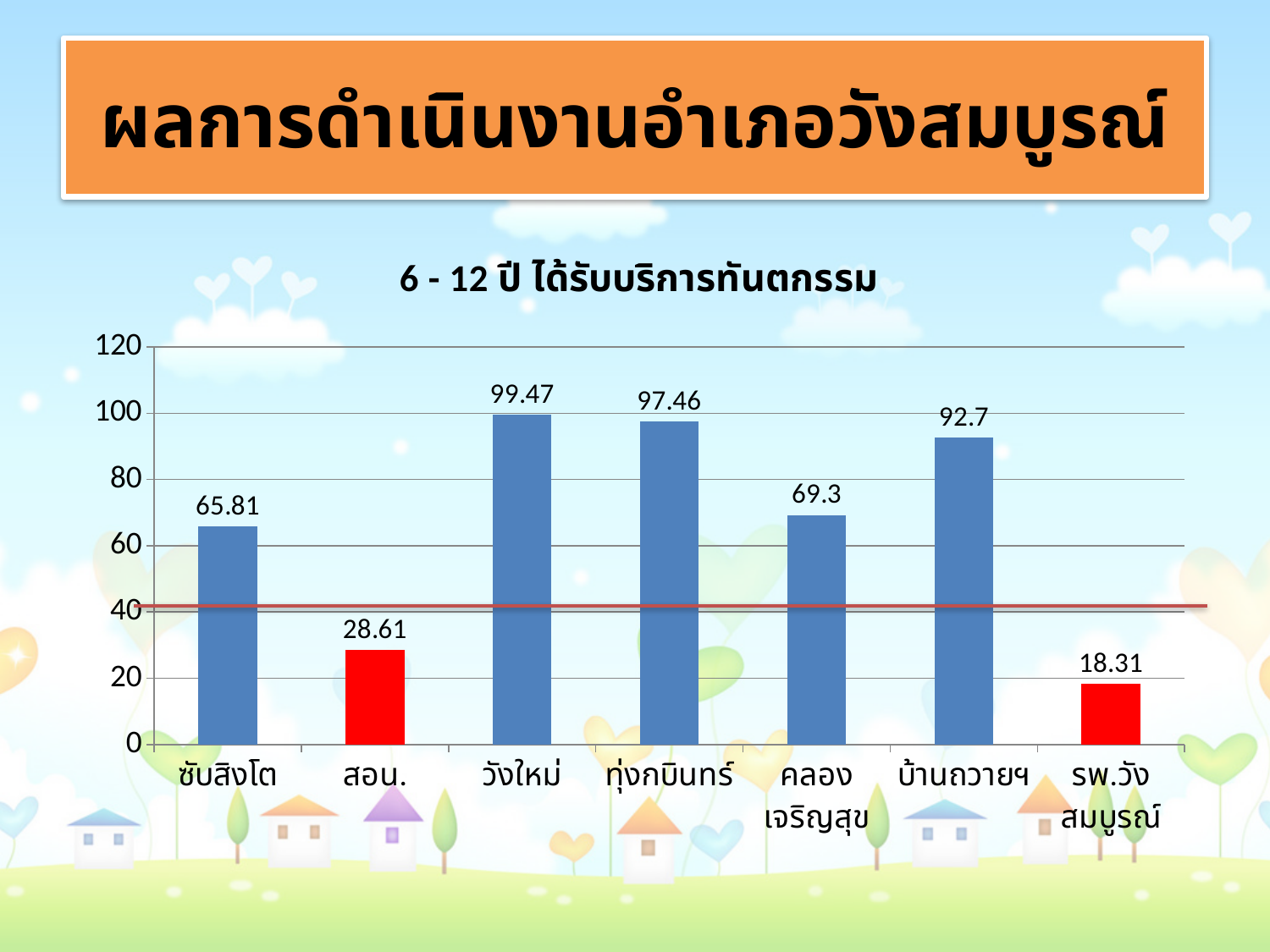
Which category has the lowest value? รพ.วังสมบูรณ์ Which category has the highest value? วังใหม่ What is the value for บ้านถวายฯ? 92.7 What is the difference between the values for ซับสิงโต and คลองเจริญสุข? 3.49 What is the value for สอน.? 28.61 Is the value for รพ.วังสมบูรณ์ greater or less than 20? less What kind of chart is this? bar chart How many bars are coloured red? 2 What is the title of the chart? 6 - 12 ปี ได้รับบริการทันตกรรม How many categories are shown on the x axis? 7 Which is larger, the value for ทุ่งกบินทร์ or the value for บ้านถวายฯ? ทุ่งกบินทร์ What is the value for วังใหม่? 99.47